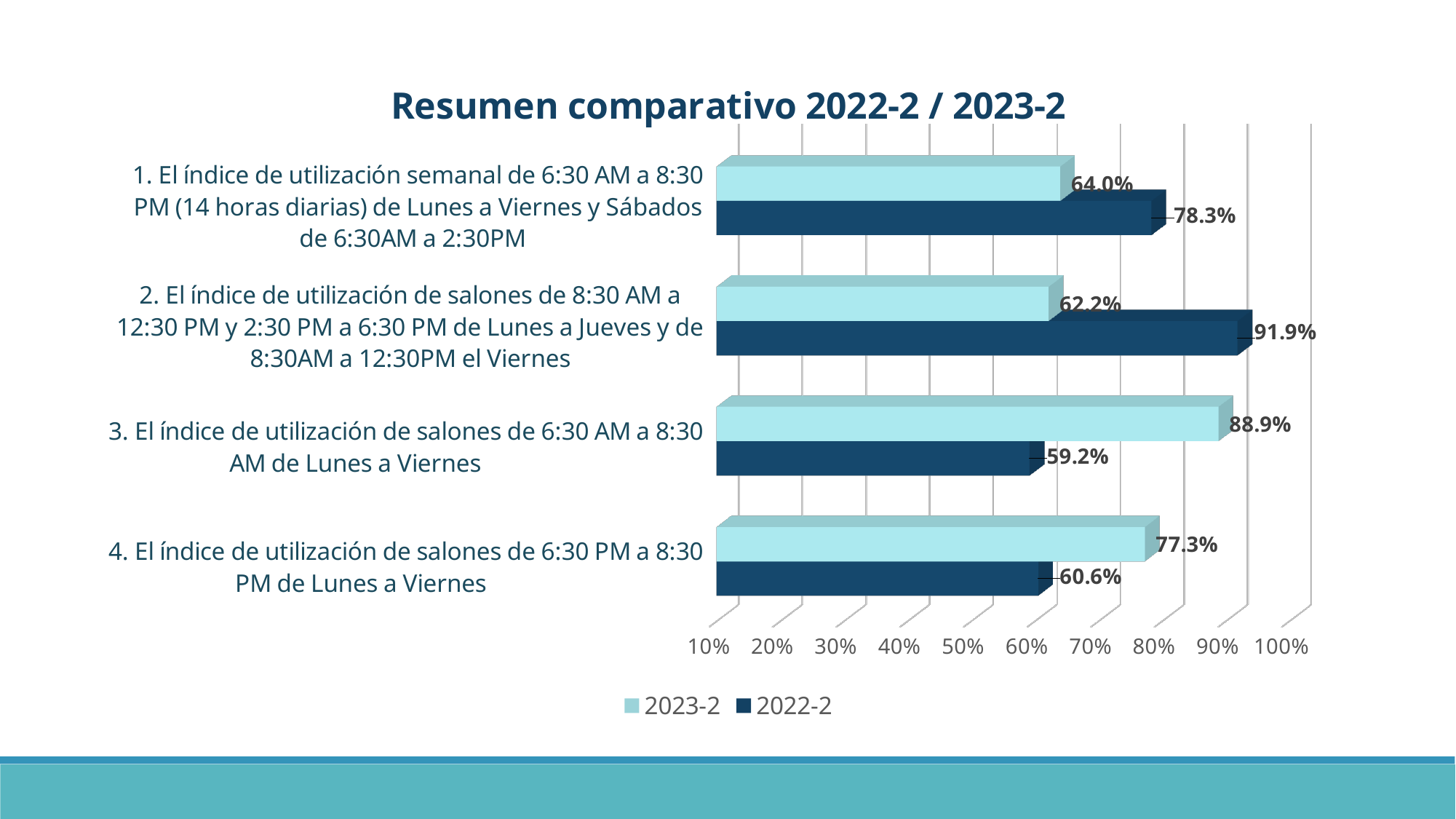
What is the difference between the 2023-2 and 2022-2 values for category 3? 29.7% What is the 2023-2 value for category 1 (El índice de utilización semanal de 6:30 AM a 8:30 PM)? 64.0% Which category has the lowest 2023-2 value? 2. El índice de utilización de salones de 8:30 AM a 12:30 PM y 2:30 PM a 6:30 PM de Lunes a Jueves y de 8:30AM a 12:30PM el Viernes How many series does the legend list? 2 For category 4, which series has the larger value, 2023-2 or 2022-2? 2023-2 What is the 2022-2 value for category 4 (El índice de utilización de salones de 6:30 PM a 8:30 PM de Lunes a Viernes)? 60.6% Which category has the highest 2022-2 value? 2. El índice de utilización de salones de 8:30 AM a 12:30 PM y 2:30 PM a 6:30 PM de Lunes a Jueves y de 8:30AM a 12:30PM el Viernes What is the difference between the 2022-2 and 2023-2 values for category 2? 29.7% What is the 2022-2 value for category 2 (El índice de utilización de salones de 8:30 AM a 12:30 PM y 2:30 PM a 6:30 PM de Lunes a Jueves y de 8:30AM a 12:30PM el Viernes)? 91.9% What is the 2023-2 value for category 3 (El índice de utilización de salones de 6:30 AM a 8:30 AM de Lunes a Viernes)? 88.9% How many categories are shown in the chart? 4 What type of chart is shown on the slide? Bar chart